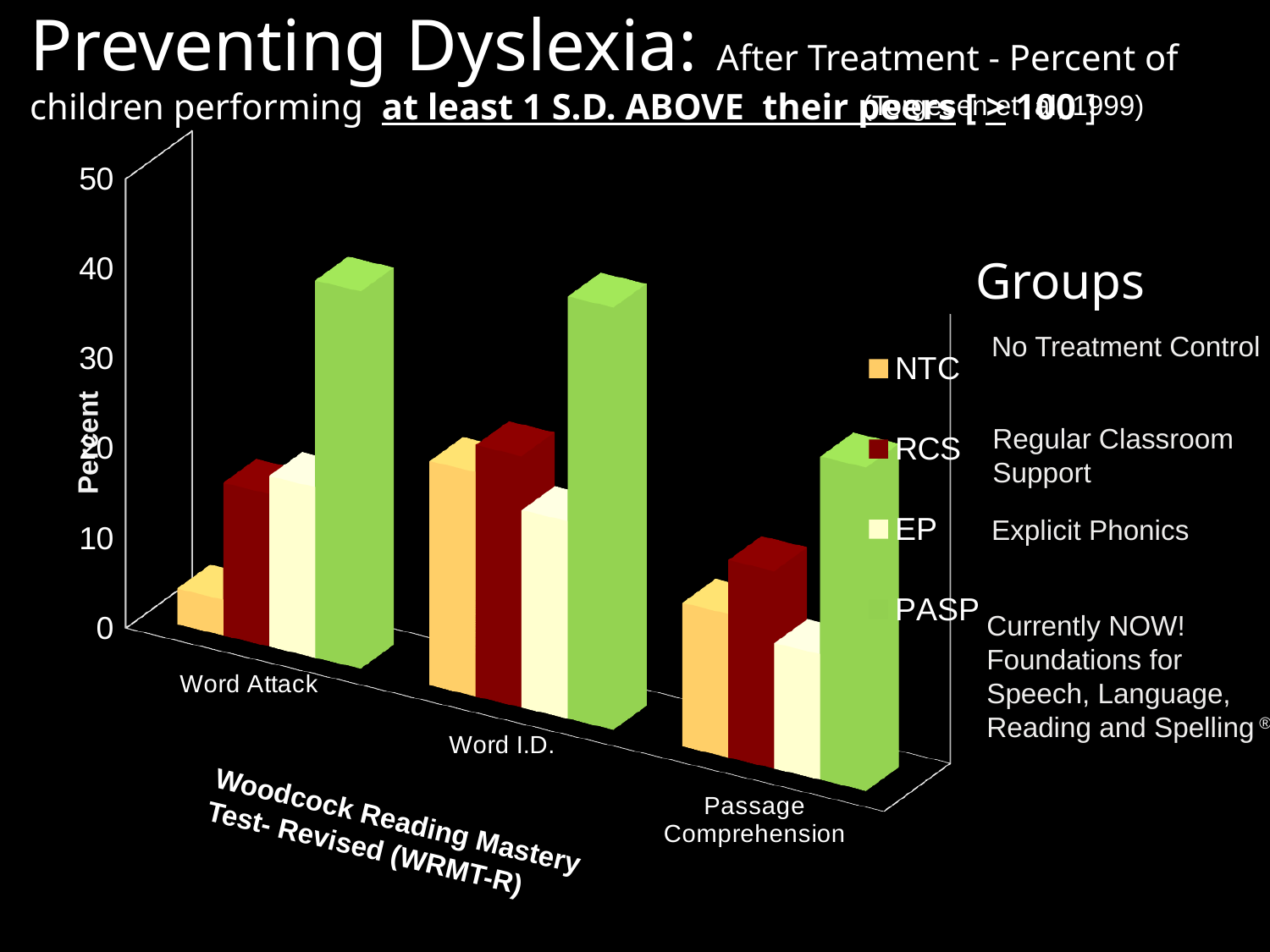
Which group has the highest bar for Word Attack? PASP How many test categories are shown along the x axis? 3 What kind of chart is shown on the slide? bar chart Is the NTC value for Word Attack greater or less than 10? less What does the legend entry NTC stand for, according to the slide? No Treatment Control Which group has the lowest bar for Word Attack? NTC For Word I.D., which is larger, the PASP bar or the EP bar? PASP Is the PASP value for Word Attack greater or less than 30? greater Which group has the highest bar for Passage Comprehension? PASP How many groups does the legend list? 4 What is the label on the vertical axis? Percent